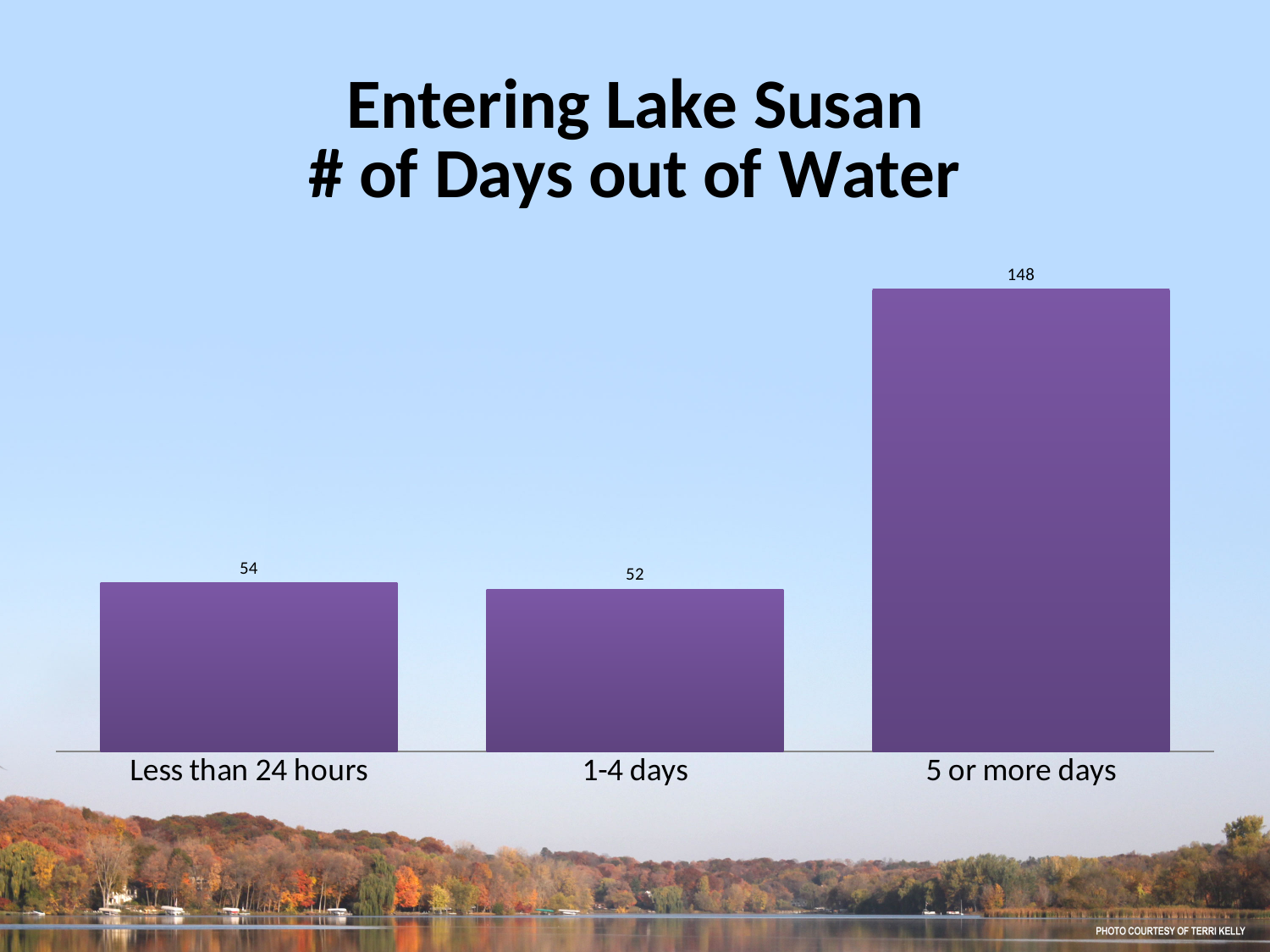
How many categories are shown in the chart? 3 What is the difference between the values for "Less than 24 hours" and "1-4 days"? 2 What is the title of the chart? Entering Lake Susan # of Days out of Water What is the value for "1-4 days"? 52 What is the value for "5 or more days"? 148 What is the difference between the values for "5 or more days" and "Less than 24 hours"? 94 Which is larger, the value for "5 or more days" or the value for "1-4 days"? 5 or more days Which category has the highest value? 5 or more days What is the value for "Less than 24 hours"? 54 What kind of chart is shown on the slide? bar chart What is the total of the three values shown in the chart? 254 What colour are the bars in the chart? purple